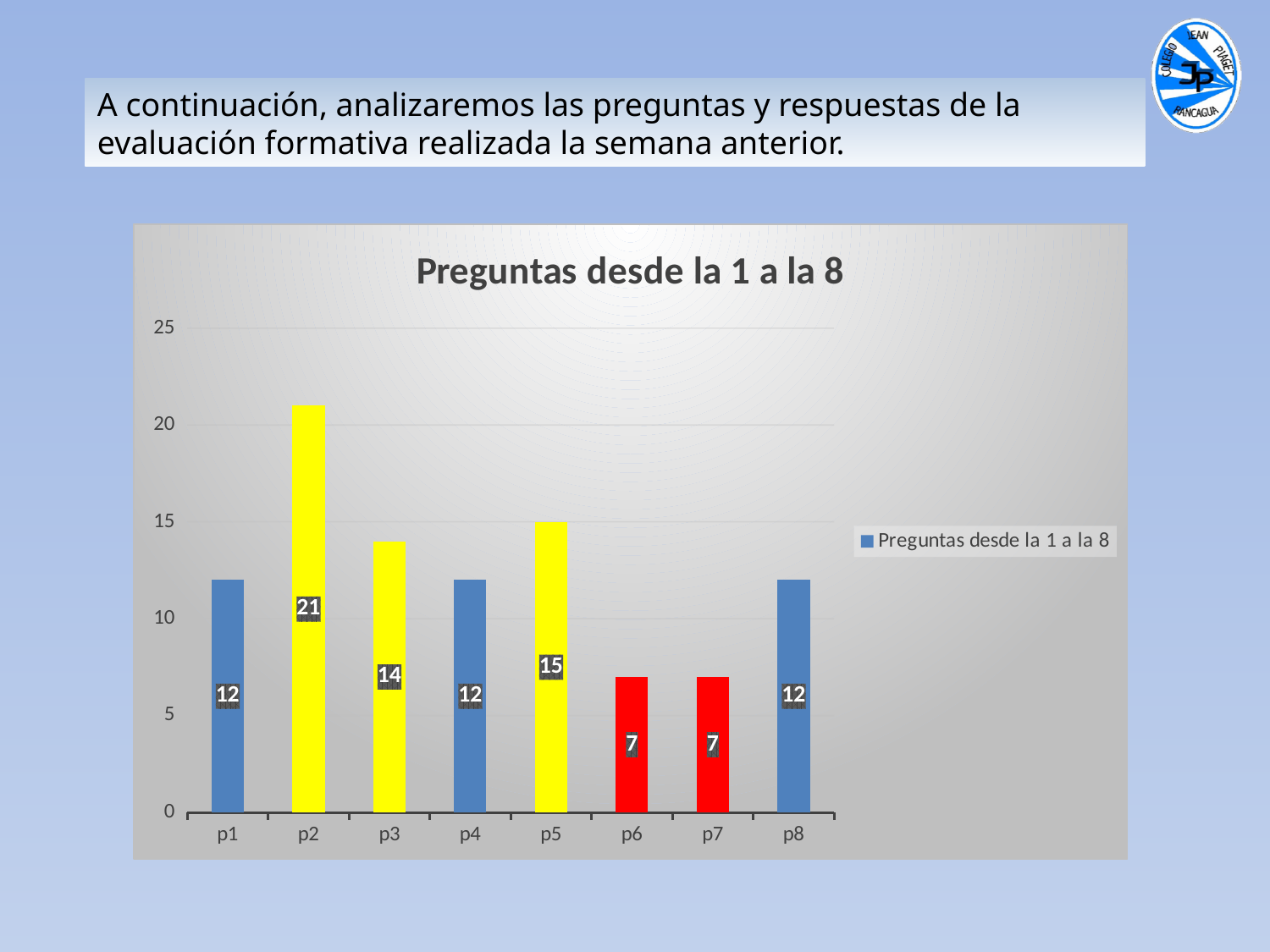
Is the value for p2 greater or less than 20? greater How many series does the legend list? 1 Which category has the highest value? p2 Which is larger, the value for p3 or the value for p4? p3 What kind of chart is shown? bar chart What is the title of the chart? Preguntas desde la 1 a la 8 What is the value for p2? 21 What is the value for p6? 7 How many categories are shown on the x axis? 8 What is the value for p5? 15 What is the difference between the values for p2 and p3? 7 What colour are the bars for p6 and p7? red